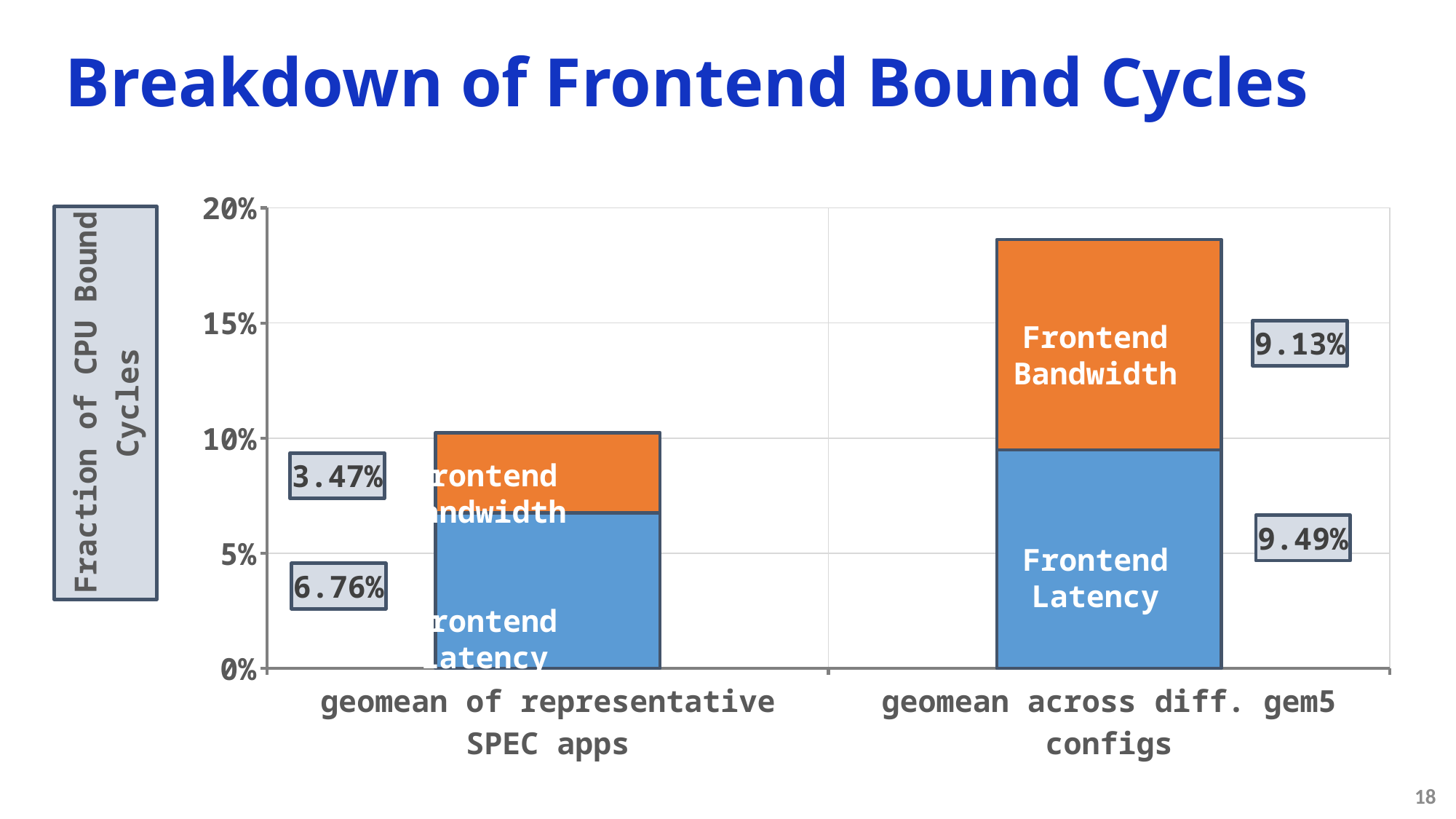
What is the Frontend Bandwidth value for geomean of representative SPEC apps? 3.47% What is the total height of the stacked bar for geomean of representative SPEC apps? 10.23% What is the y-axis title of the chart? Fraction of CPU Bound Cycles What is the Frontend Latency value for geomean across diff. gem5 configs? 9.49% What is the total height of the stacked bar for geomean across diff. gem5 configs? 18.62% What is the Frontend Latency value for geomean of representative SPEC apps? 6.76% What kind of chart is shown on the slide? Stacked bar chart What is the Frontend Bandwidth value for geomean across diff. gem5 configs? 9.13% For geomean across diff. gem5 configs, which is larger: Frontend Latency or Frontend Bandwidth? Frontend Latency What is the difference in Frontend Bandwidth between geomean across diff. gem5 configs and geomean of representative SPEC apps? 5.66% What is the difference in Frontend Latency between geomean across diff. gem5 configs and geomean of representative SPEC apps? 2.73% Which category has the higher Frontend Latency value? geomean across diff. gem5 configs